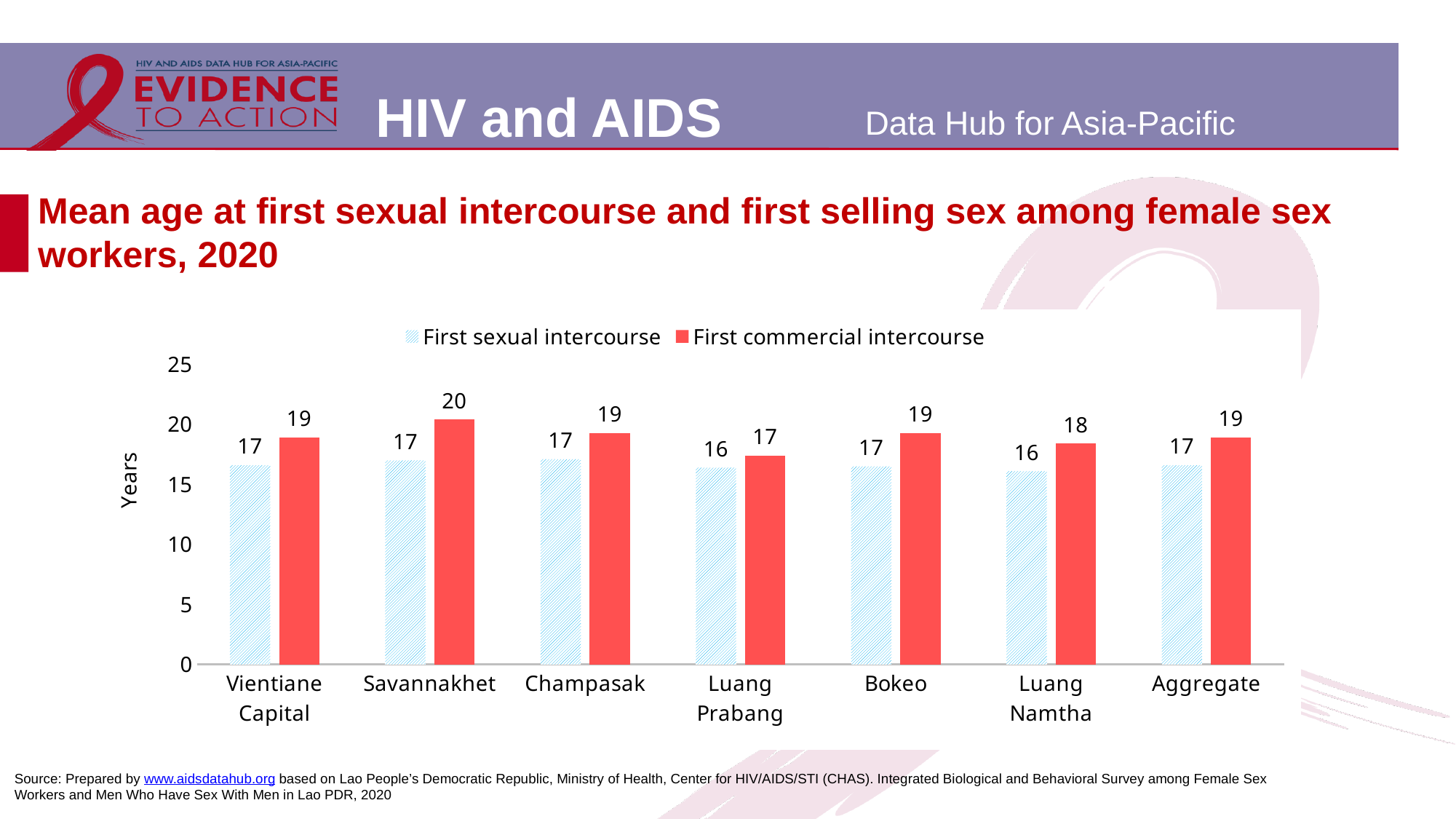
What kind of chart is shown on the slide? Bar chart How many series does the legend list? 2 How many categories are shown on the x axis? 7 Which province has the highest mean age at first commercial intercourse? Savannakhet Is the value for first commercial intercourse in Bokeo greater or less than 15? greater Which category has the lowest mean age at first commercial intercourse? Luang Prabang What is the difference between first commercial intercourse and first sexual intercourse in Savannakhet? 3 What is the Aggregate value for first commercial intercourse? 19 What is the mean age at first sexual intercourse in Luang Namtha? 16 What is the mean age at first commercial intercourse in Savannakhet? 20 What is the label on the vertical axis? Years Which is larger in Luang Namtha: the age at first sexual intercourse or the age at first commercial intercourse? First commercial intercourse